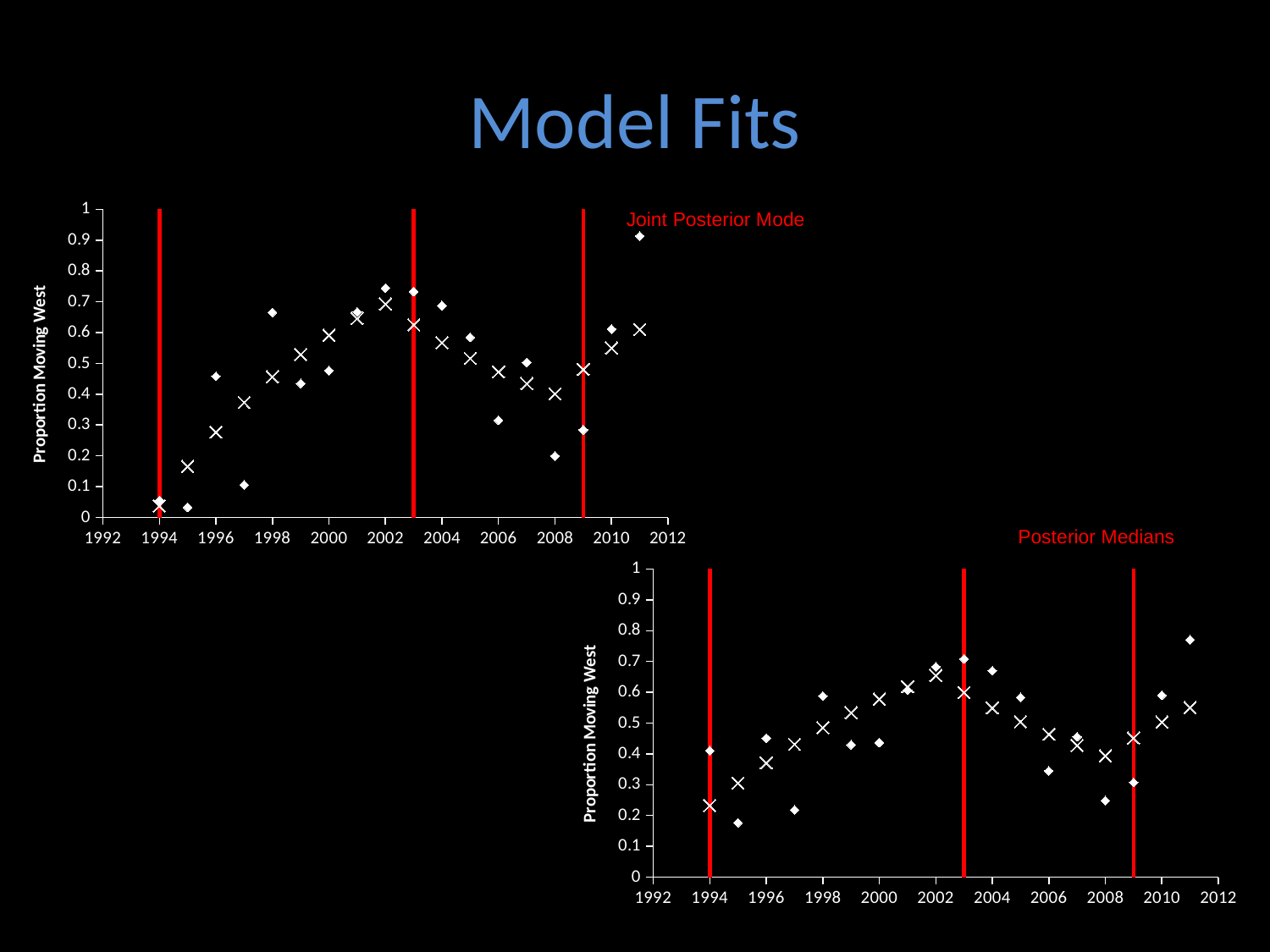
In the 'Joint Posterior Mode' chart, is the diamond value for 1998 greater or less than 0.6? greater How many red vertical lines are drawn on the 'Joint Posterior Mode' chart? 3 What is the y-axis label of the 'Posterior Medians' chart? Proportion Moving West In the 'Joint Posterior Mode' chart, is the cross value for 1995 greater or less than 0.2? less In the 'Posterior Medians' chart, do the cross values rise or fall from 2003 to 2008? fall In the 'Posterior Medians' chart, is the diamond value for 2011 greater or less than 0.7? greater What kind of chart is the 'Joint Posterior Mode' chart? scatter chart In the 'Joint Posterior Mode' chart, do the cross values rise or fall from 1994 to 2002? rise